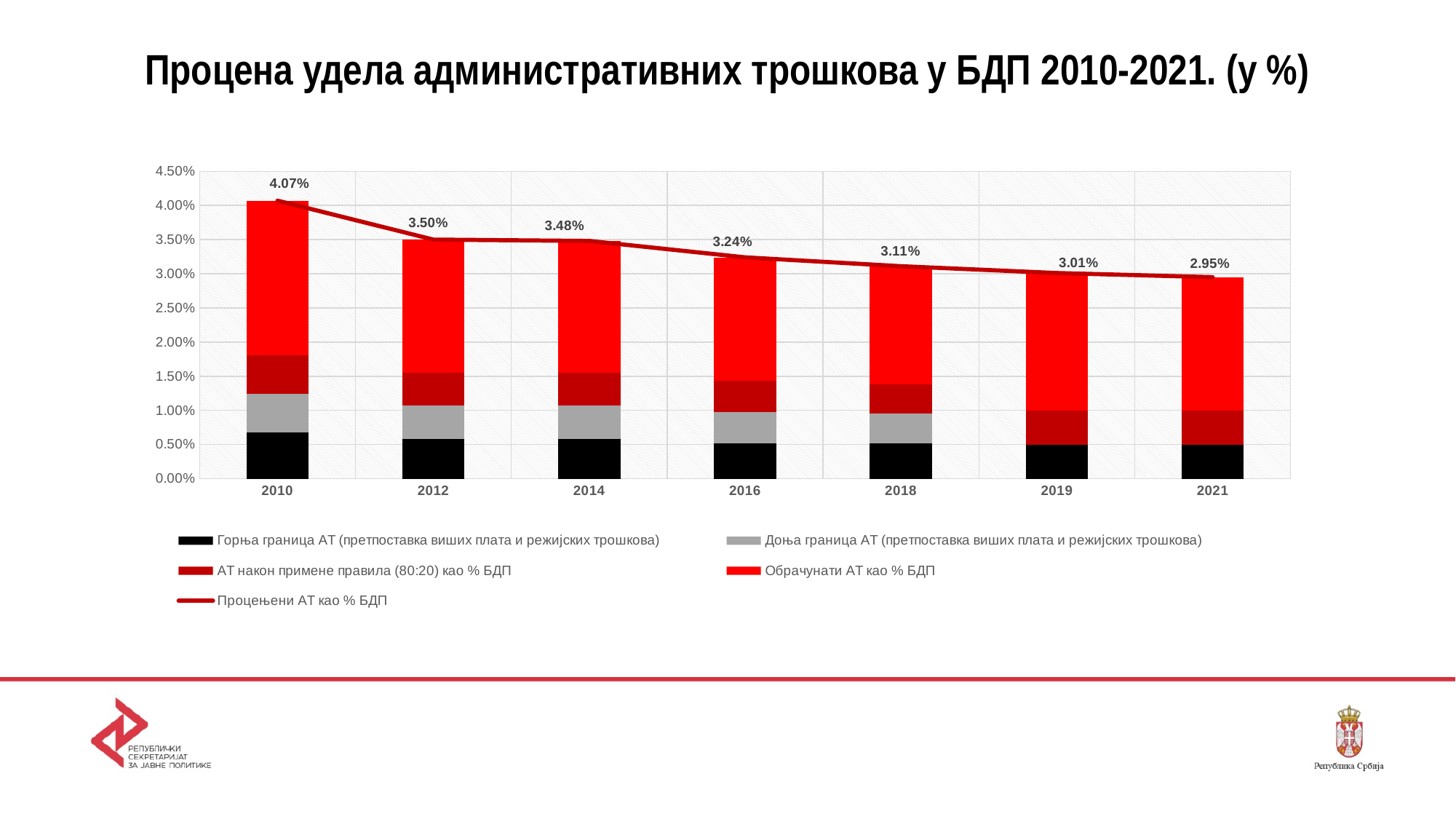
What is the value of the Процењени АТ као % БДП line for 2016? 3.24% Does the Процењени АТ као % БДП line rise or fall from 2010 to 2021? Fall What is the difference between the Процењени АТ као % БДП values for 2010 and 2021? 1.12 percentage points Which year has a higher Процењени АТ као % БДП value, 2012 or 2018? 2012 What is the value of the Процењени АТ као % БДП line for 2010? 4.07% What is the value of the Процењени АТ као % БДП line for 2021? 2.95% How many series does the chart legend list? 5 In which year is the Процењени АТ као % БДП line highest? 2010 Is the value of the Процењени АТ као % БДП line for 2019 greater or less than 3.50%? less What kind of chart is shown on the slide? Stacked bar chart with a line In which year is the Процењени АТ као % БДП line lowest? 2021 How many years are shown on the x axis of the chart? 7